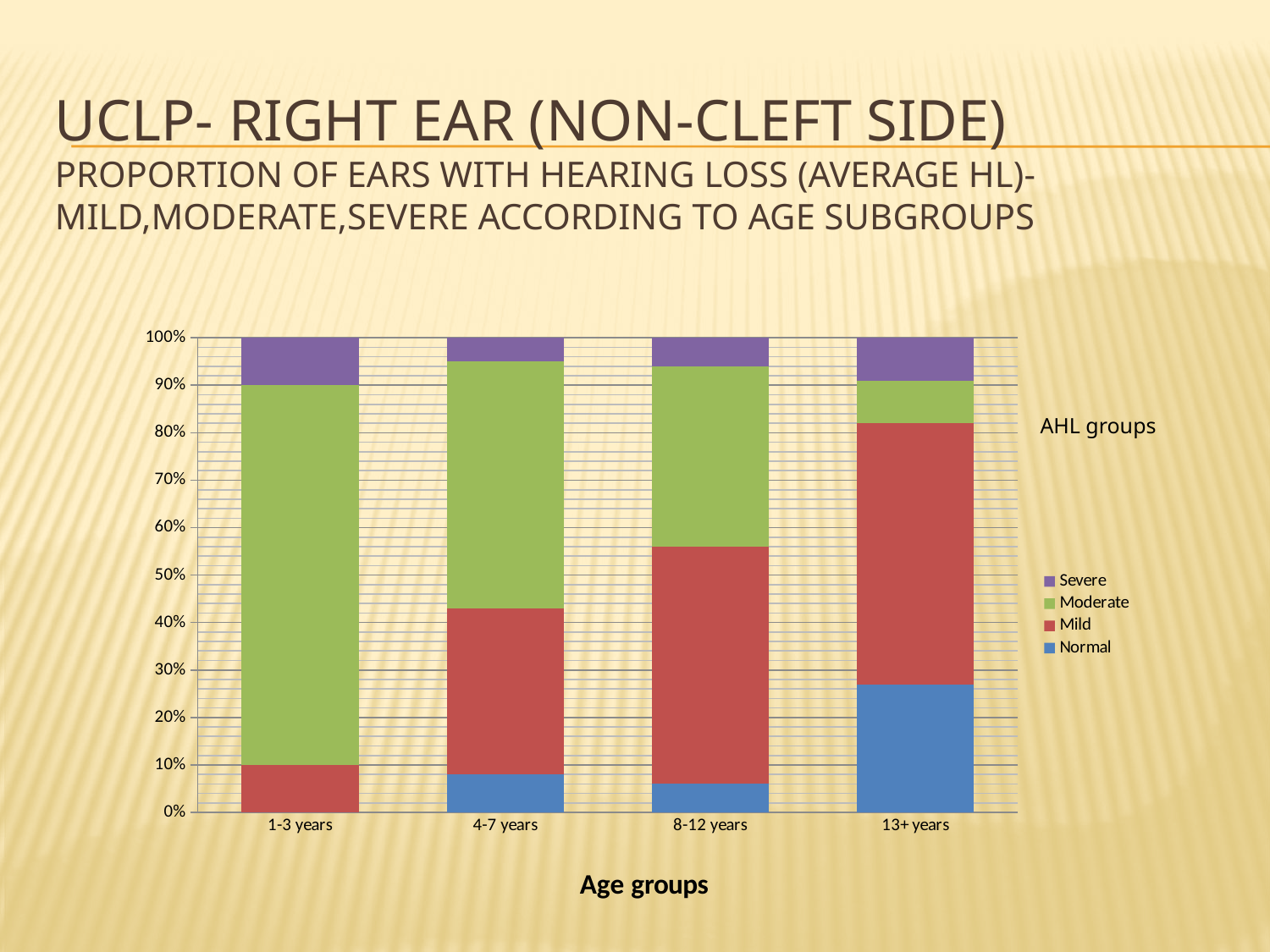
Which age group has the smallest Normal share? 1-3 years How many age groups are shown on the x axis of the chart? 4 Which age group has the largest Normal share? 13+ years What kind of chart is shown on the slide? Stacked bar chart Is the Normal share for 8-12 years greater or less than 10%? less Is the Moderate share larger for 1-3 years or for 13+ years? 1-3 years Does the Moderate share rise or fall across the age groups from 1-3 years to 13+ years? Fall How many series does the chart legend list? 4 Is the Normal share for 13+ years greater or less than 20%? greater Which age group has the largest Moderate share? 1-3 years What is the title of the chart legend? AHL groups What is the x-axis title of the chart? Age groups